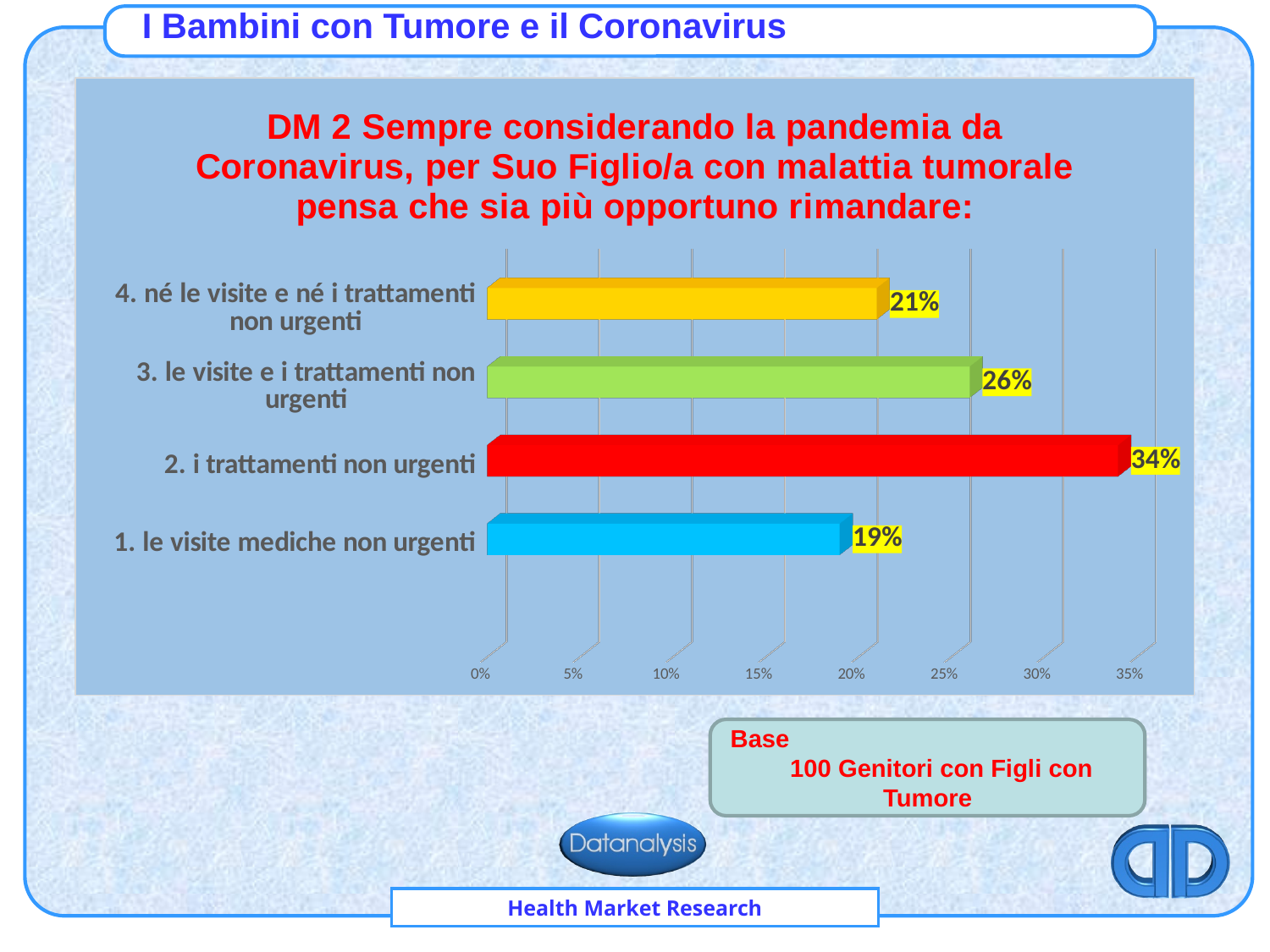
Which is larger: the value for "3. le visite e i trattamenti non urgenti" or for "4. né le visite e né i trattamenti non urgenti"? 3. le visite e i trattamenti non urgenti What is the value for "1. le visite mediche non urgenti"? 19% Which category has the lowest value? 1. le visite mediche non urgenti How many categories are shown in the chart? 4 What is the value for "4. né le visite e né i trattamenti non urgenti"? 21% What is the value for "3. le visite e i trattamenti non urgenti"? 26% What colour is the bar for "2. i trattamenti non urgenti"? red Which category has the highest value? 2. i trattamenti non urgenti What is the difference between the values for "2. i trattamenti non urgenti" and "1. le visite mediche non urgenti"? 15% What is the value for "2. i trattamenti non urgenti"? 34% Is the value for "2. i trattamenti non urgenti" greater or less than 30%? greater What kind of chart is shown on the slide? bar chart